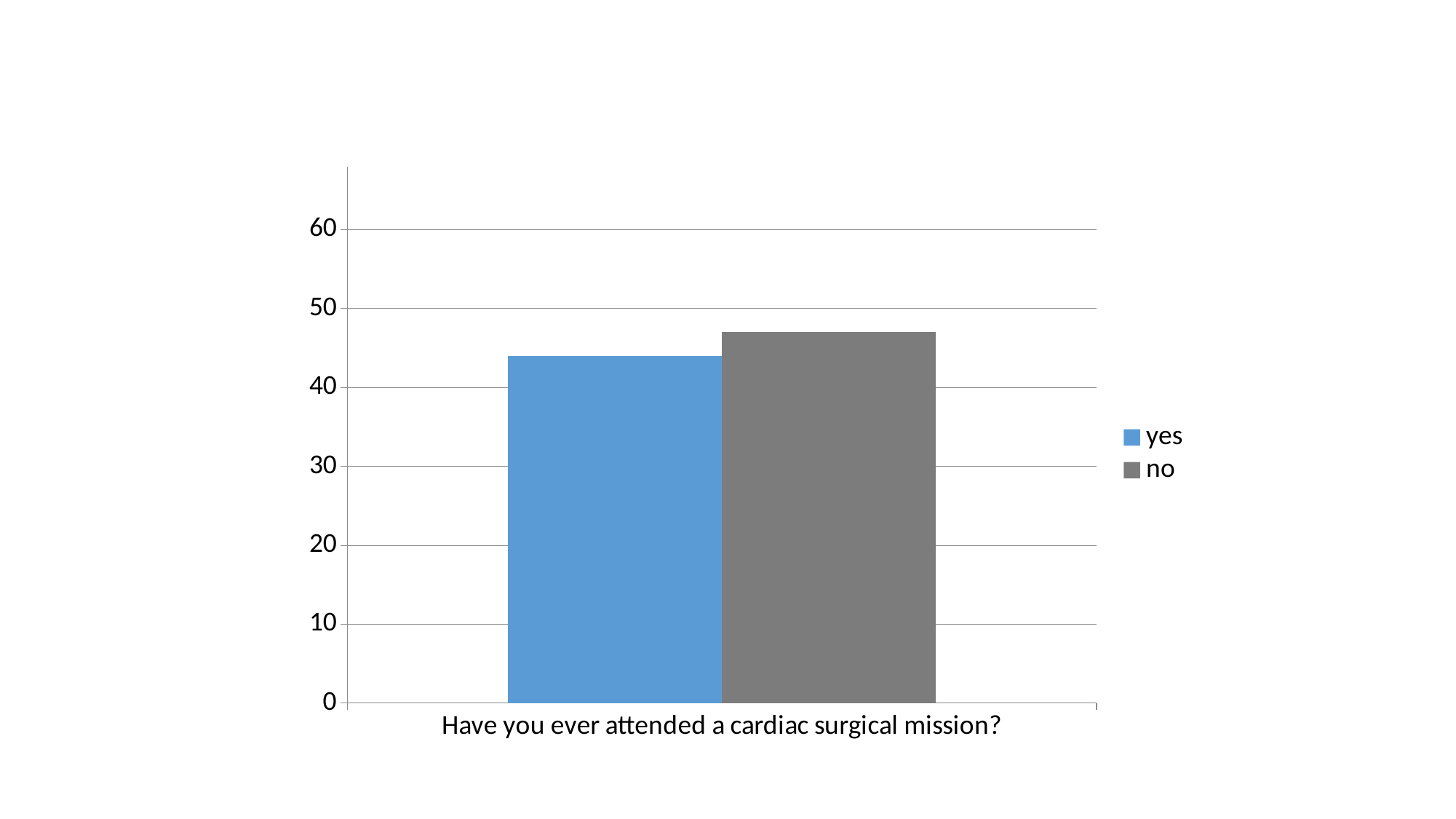
Is the value for yes greater or less than 40? greater Is the value for no greater or less than 40? greater What is the category label shown on the x axis? Have you ever attended a cardiac surgical mission? Which series has the lowest value? yes How many series does the legend list? 2 Which series has the taller bar, yes or no? no Which series has the highest value? no How many categories are shown on the x axis? 1 What kind of chart is shown on the slide? bar chart Is the value for yes greater or less than 50? less What colour is the bar for the yes series? blue